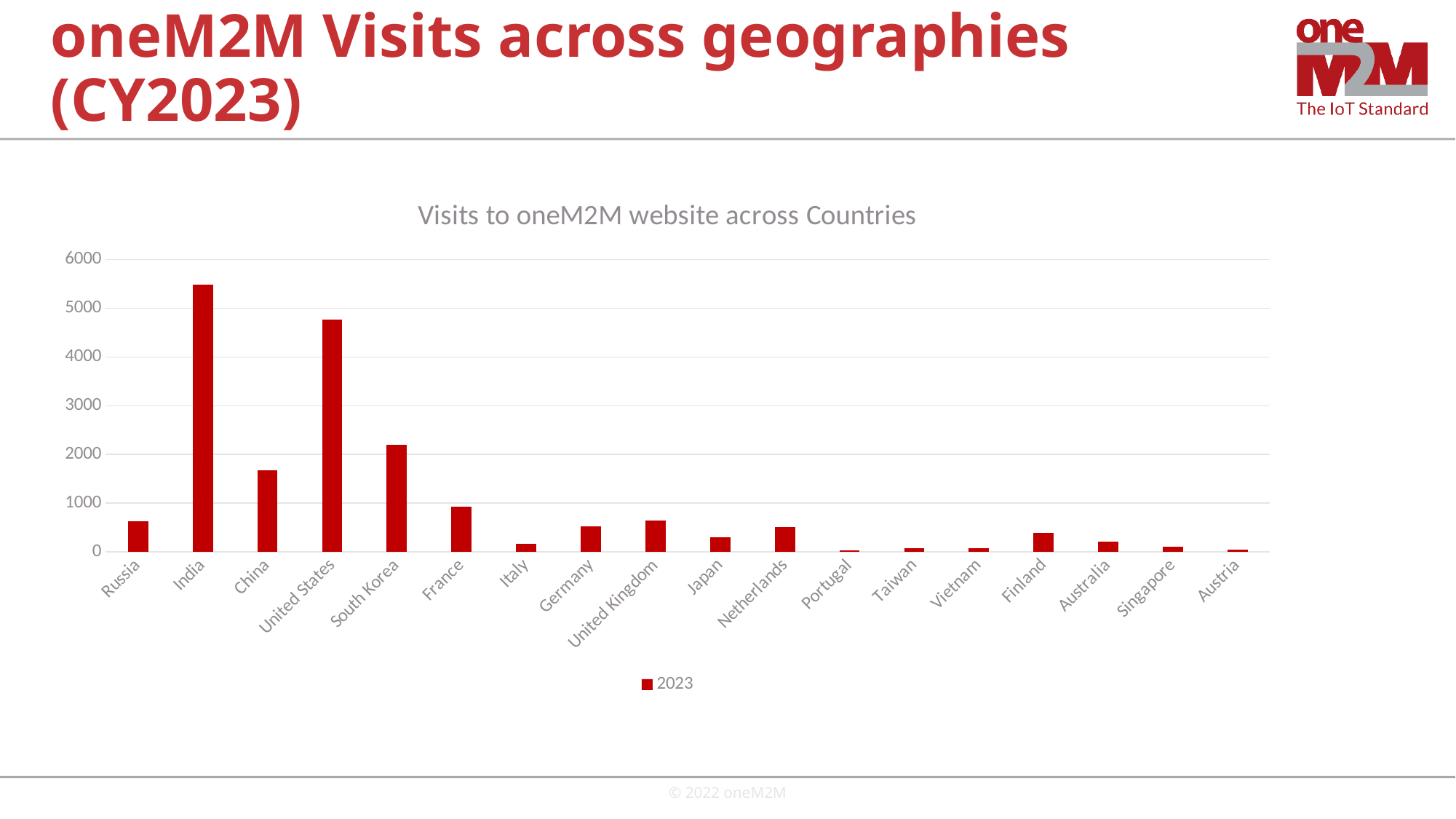
Is the value for China greater or less than 1000? greater How many countries are shown on the x axis of the chart? 18 How many series does the legend list? 1 Is the value for India greater or less than 5000? greater Is the value for United States greater or less than 5000? less What kind of chart is shown on the slide? bar chart Which has more visits, Finland or Australia? Finland Which country has the highest number of visits to the oneM2M website? India Which has more visits, United Kingdom or Japan? United Kingdom What is the title of the chart? Visits to oneM2M website across Countries